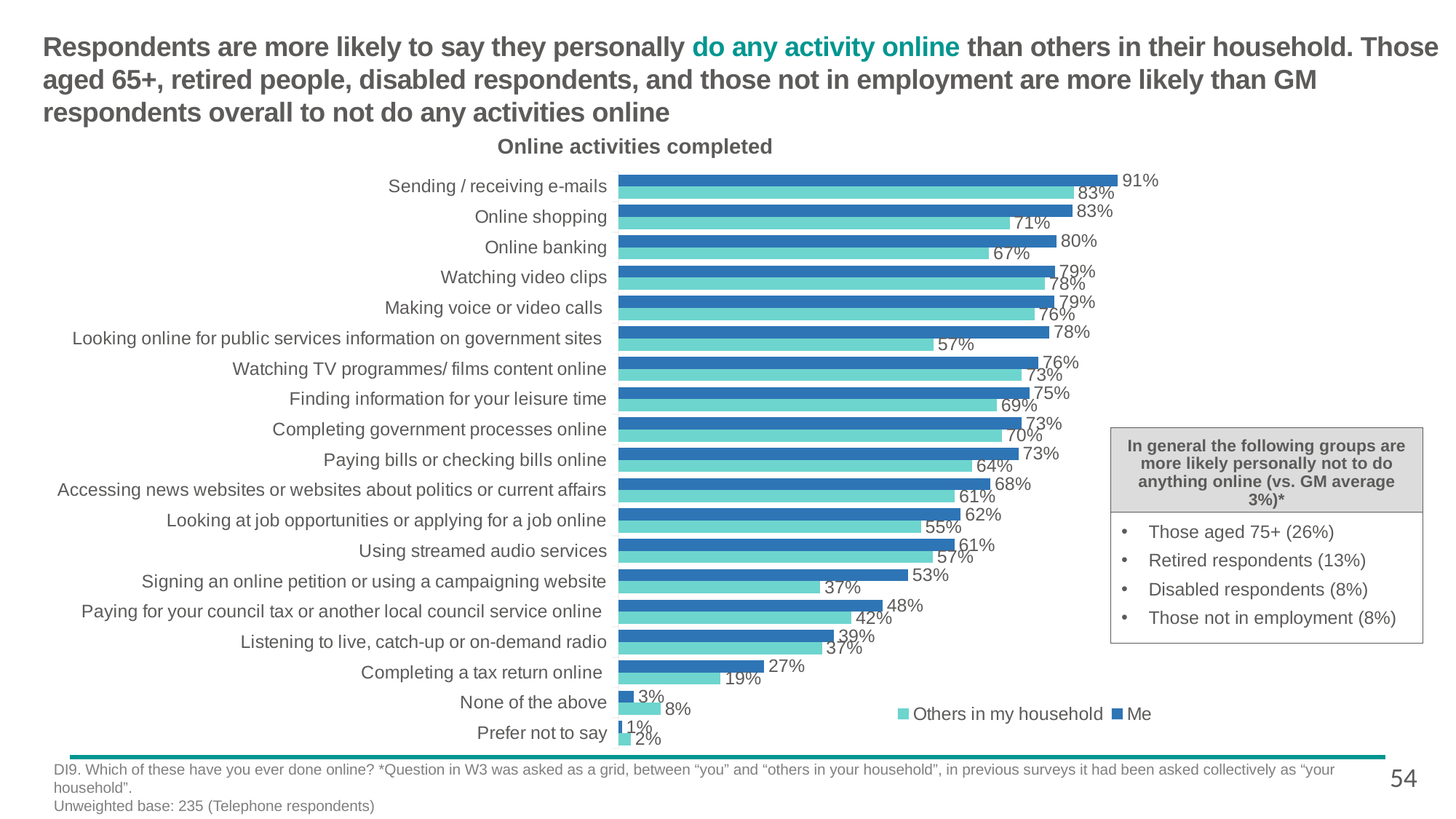
How many series does the legend list? 2 What is the difference between "Me" and "Others in my household" for Looking online for public services information on government sites? 21 percentage points What kind of chart is shown? Bar chart What is the value for "Me" for Completing a tax return online? 27% What is the title of the chart? Online activities completed What is the value for "Me" for Sending / receiving e-mails? 91% For None of the above, which is larger: "Me" or "Others in my household"? Others in my household How many categories are shown on the chart? 19 Which category has the lowest value for "Others in my household"? Prefer not to say What is the value for "Others in my household" for Signing an online petition or using a campaigning website? 37% What is the value for "Others in my household" for Online banking? 67% Which activity has the highest value for "Me"? Sending / receiving e-mails